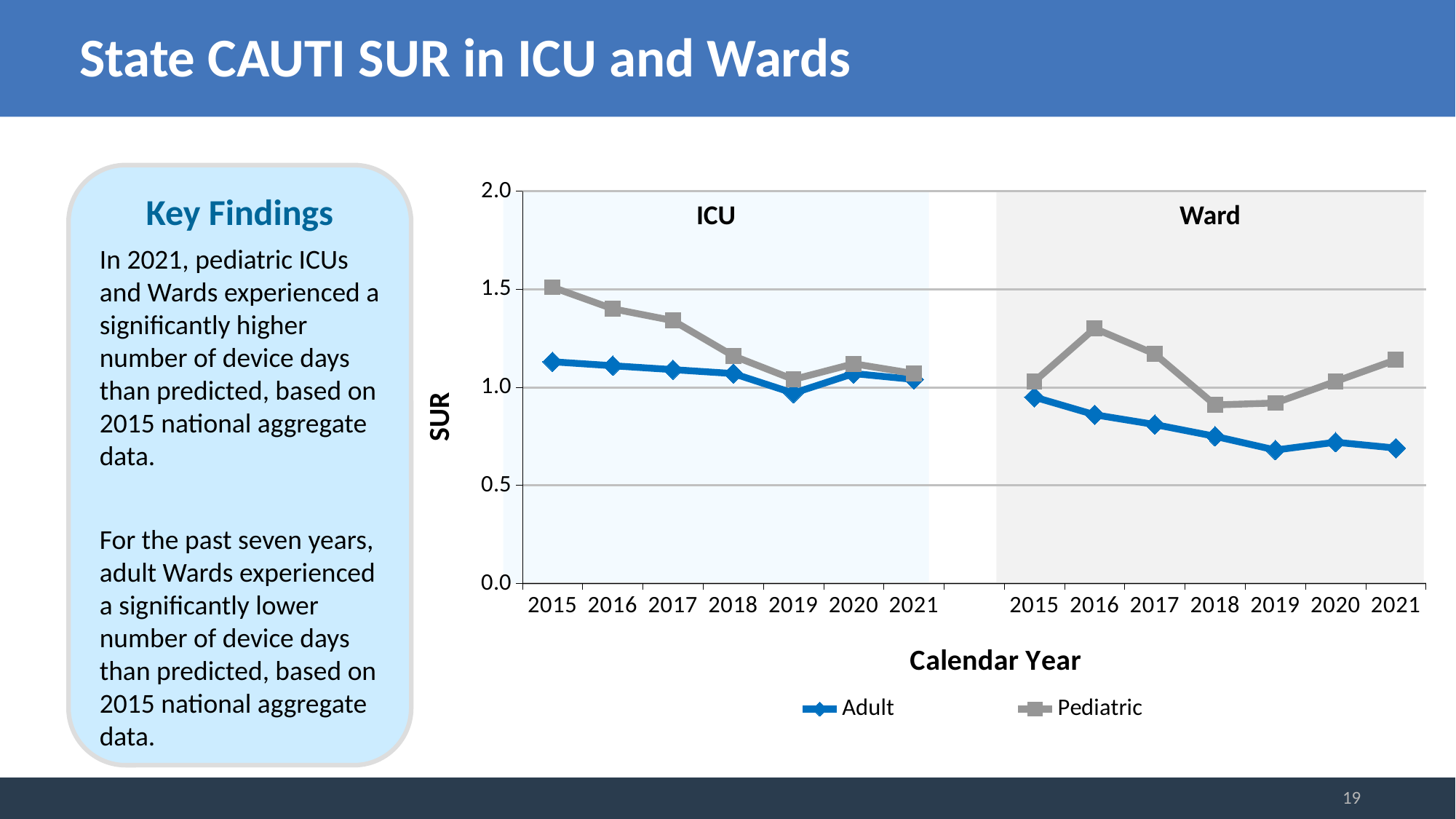
Does the Adult SUR in the Ward panel generally rise or fall from 2015 to 2021? fall In the Ward panel, is the Adult value for 2019 greater or less than 0.5? greater How many series does the chart legend list? 2 How many calendar years are plotted in the ICU panel of the chart? 7 What kind of chart is shown on the slide? line chart In the ICU panel for 2015, which series has the higher SUR, Adult or Pediatric? Pediatric In the ICU panel, which year has the highest Pediatric SUR? 2015 In the ICU panel, is the Pediatric value for 2015 greater or less than 1.0? greater In the Ward panel, which year has the highest Pediatric SUR? 2016 In the Ward panel, is the Adult value for 2021 greater or less than 1.0? less For 2021, is the Adult SUR higher in the ICU panel or the Ward panel? ICU